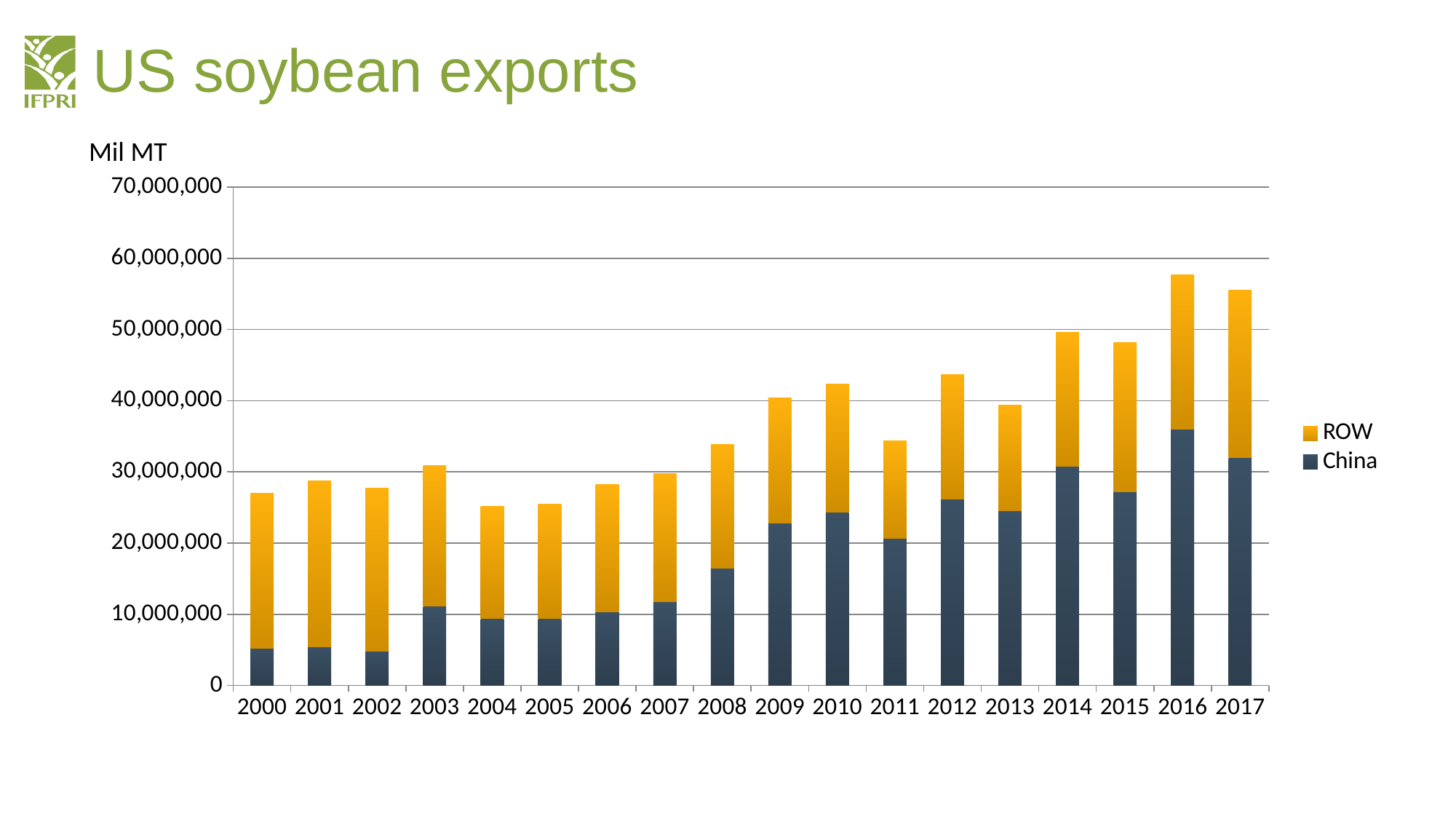
Overall, do total US soybean exports rise or fall from 2000 to 2017? Rise Which year has the highest total US soybean exports? 2016 What kind of chart is shown on the slide? Stacked bar chart Is the value for China in 2000 greater or less than 10,000,000? less Is the total bar for 2012 greater or less than 40,000,000? greater Is the value for China in 2016 greater or less than 30,000,000? greater Which year has the larger total exports, 2016 or 2017? 2016 Which year has the highest value for China? 2016 How many series does the legend list? 2 How many years are shown on the x axis? 18 Which year has the larger value for China, 2014 or 2015? 2014